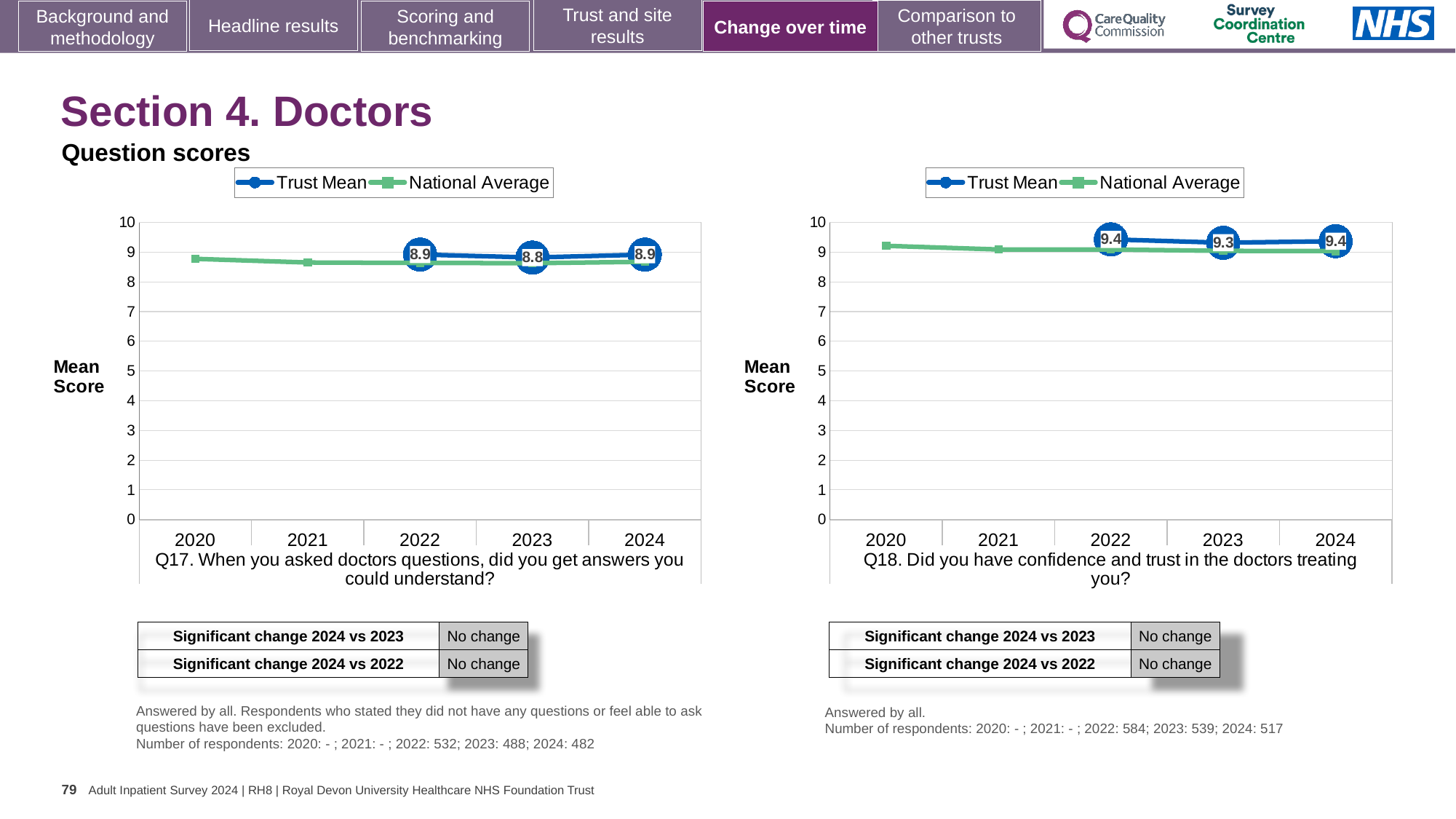
How many series does the legend of the Q17 chart (left) list? 2 On the Q18 chart (right), what is the Trust Mean score for 2023? 9.3 On the Q17 chart (left), which year has the lowest labelled Trust Mean score? 2023 How many years are shown on the x axis of the Q18 chart (right)? 5 On the Q18 chart (right), what is the difference between the Trust Mean scores for 2024 and 2023? 0.1 On the Q17 chart (left), what is the Trust Mean score for 2024? 8.9 What type of chart is used for Q18 (right)? Line chart On the Q17 chart (left), is the Trust Mean score for 2022 larger or smaller than the score for 2023? larger On the Q17 chart (left), is the National Average value for 2020 greater or less than 8? greater On the Q17 chart (left), what is the Trust Mean score for 2023? 8.8 On the Q18 chart (right), what is the Trust Mean score for 2022? 9.4 What are the two series named in the legend of the Q18 chart (right)? Trust Mean and National Average